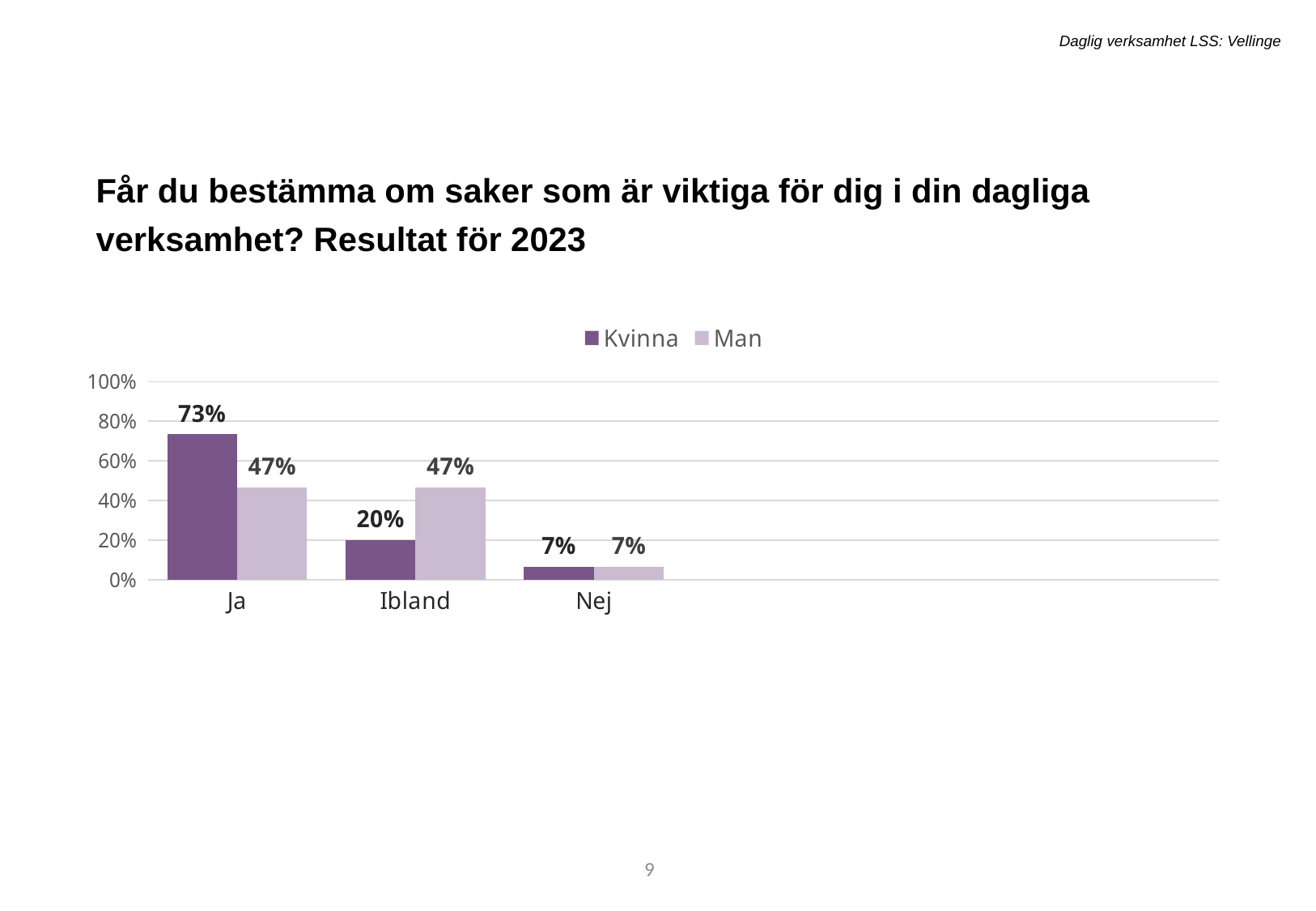
What is the value for Man in the Ibland category? 47% Is the value for Kvinna in the Ja category greater or less than 60%? greater What is the difference between the Kvinna and Man values in the Ja category? 26 percentage points Which category has the lowest value for Man? Nej What kind of chart is shown on the slide? Bar chart How many categories are shown on the x axis? 3 Which category has the highest value for Kvinna? Ja What is the value for Kvinna in the Ja category? 73% In the Ibland category, which series has the larger value, Kvinna or Man? Man What is the value for Kvinna in the Nej category? 7% Which series is shown in the darker purple colour? Kvinna How many series does the legend list? 2